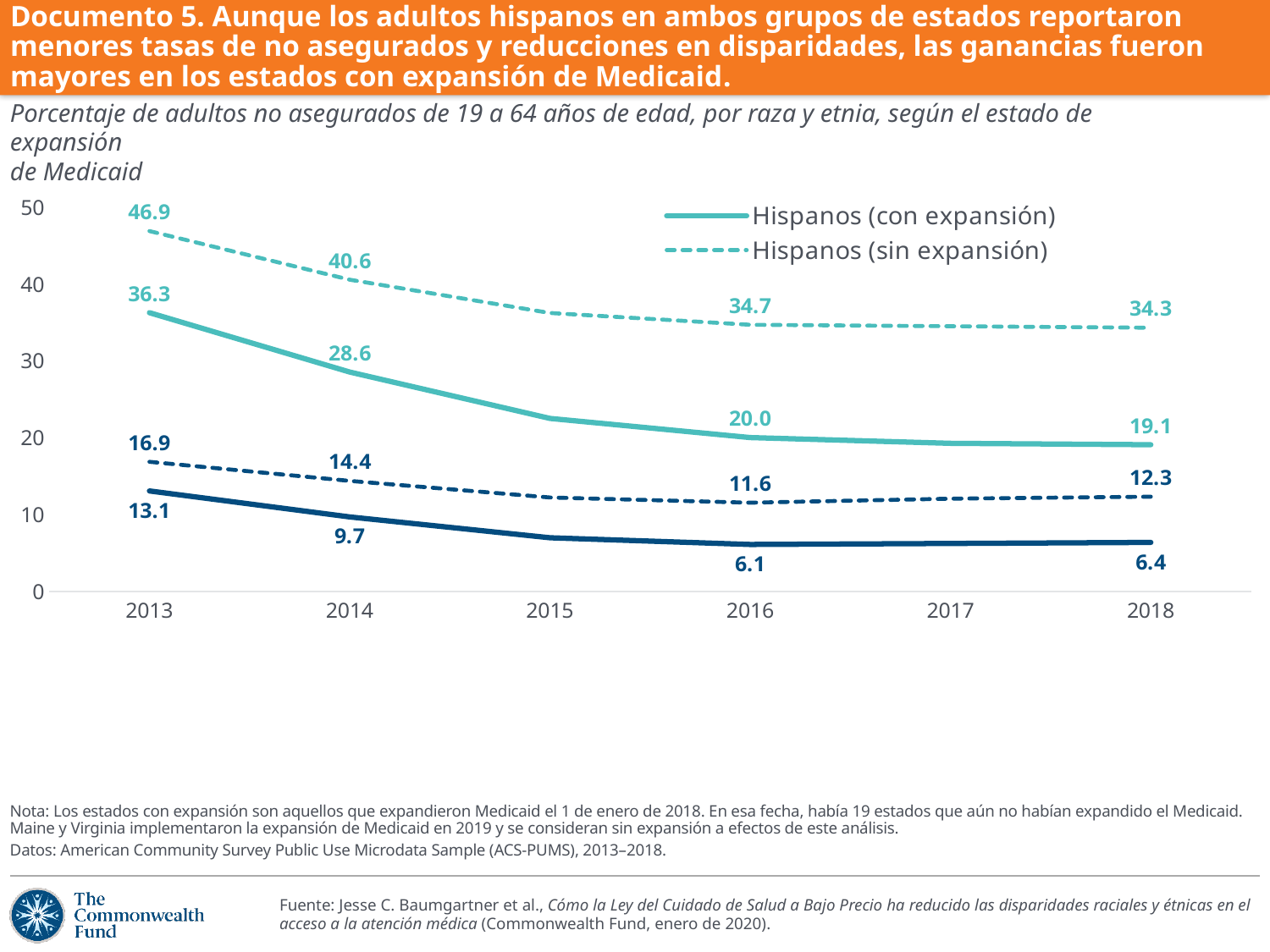
In 2018, which is larger: Hispanos (con expansión) or Hispanos (sin expansión)? Hispanos (sin expansión) What kind of chart is shown on the slide? line chart What is the value for Hispanos (con expansión) in 2013? 36.3 What is the value for Hispanos (con expansión) in 2016? 20.0 How many series does the legend list? 2 By how much did the value for Hispanos (con expansión) fall from 2013 to 2018? 17.2 Is the value for Hispanos (sin expansión) in 2017 greater or less than 40? less Is the value for Hispanos (con expansión) in 2015 greater or less than 20? greater By how much did the value for Hispanos (sin expansión) fall from 2013 to 2018? 12.6 How many years are shown on the x axis? 6 What is the value for Hispanos (sin expansión) in 2018? 34.3 What is the value for Hispanos (sin expansión) in 2014? 40.6